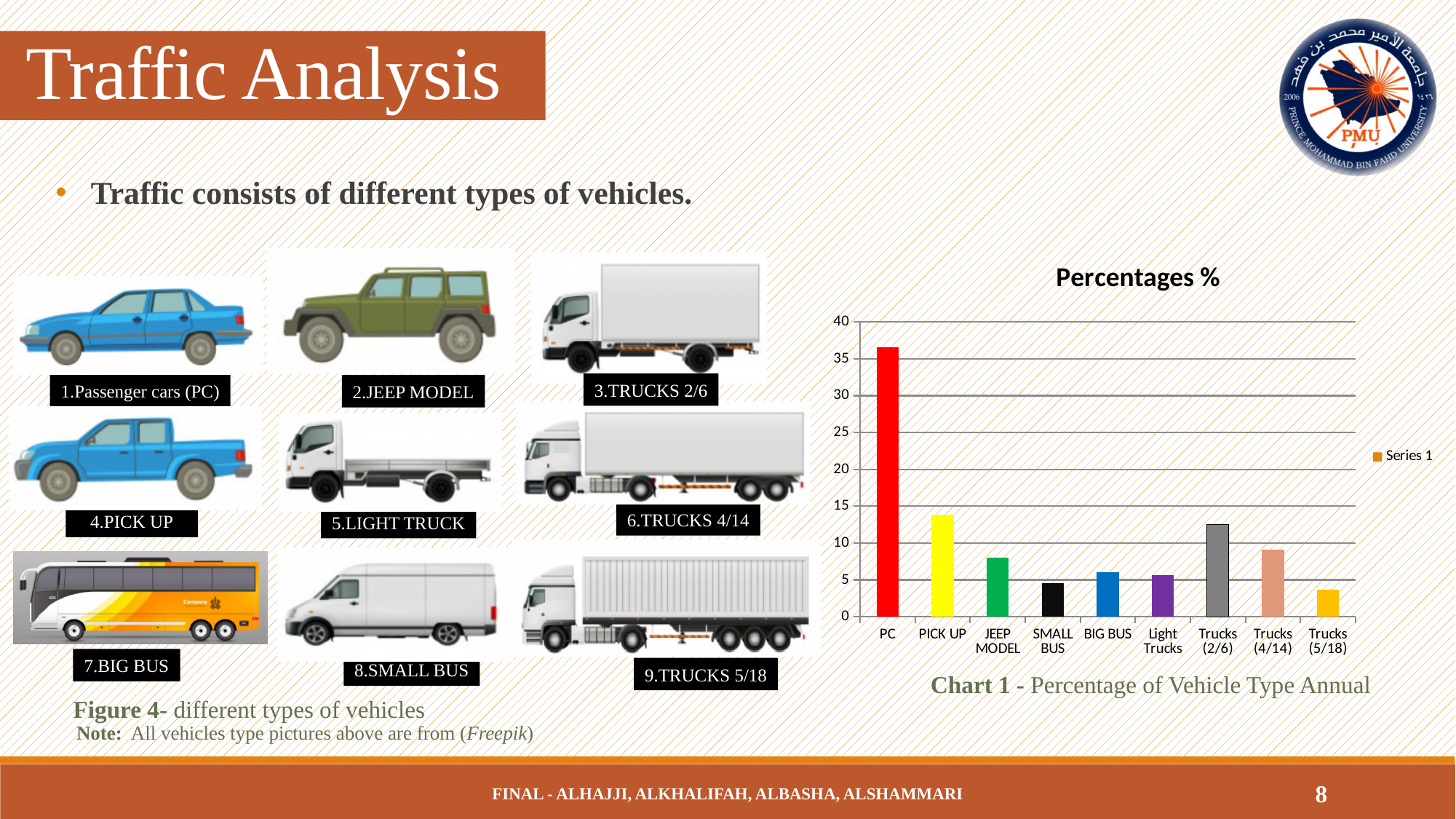
Which vehicle category has the highest percentage? PC What kind of chart is shown on the slide? bar chart What is the title of the chart? Percentages % What is the name of the series shown in the chart legend? Series 1 How many series does the chart legend list? 1 Is the value for PC greater or less than 30? greater Is the value for JEEP MODEL greater or less than 10? less Which is larger, the value for Trucks (2/6) or the value for Trucks (4/14)? Trucks (2/6) Is the value for Trucks (5/18) greater or less than 5? less Which is larger, the value for PICK UP or the value for SMALL BUS? PICK UP How many vehicle categories are plotted on the chart? 9